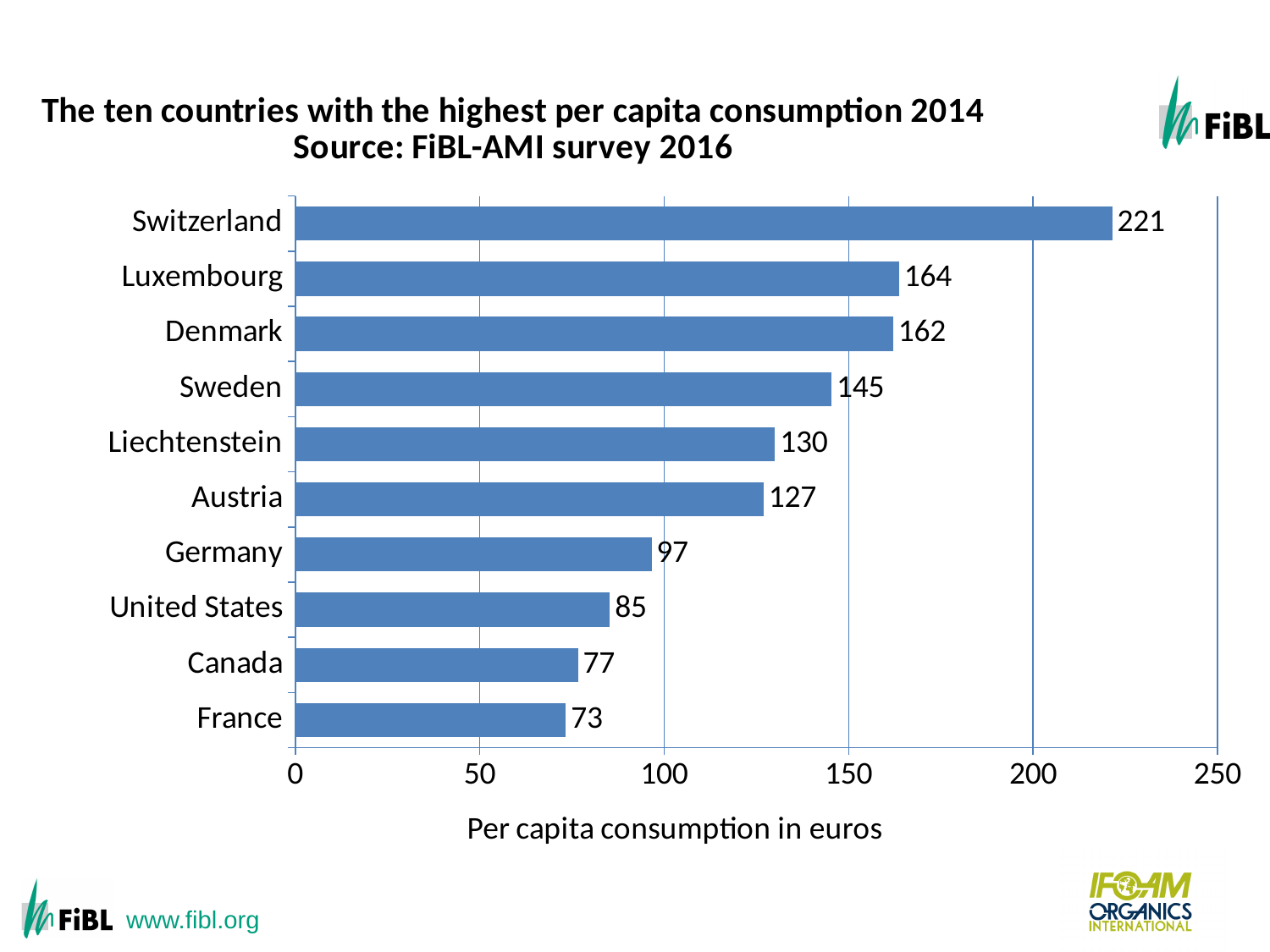
What is the label of the horizontal axis? Per capita consumption in euros How many countries are shown in the chart? 10 Which country has the lowest per capita consumption? France Which has a higher per capita consumption, Sweden or Austria? Sweden Which country has the highest per capita consumption? Switzerland What is the per capita consumption for Liechtenstein? 130 Is the value for Denmark greater or less than 150? greater What kind of chart is shown on the slide? Bar chart What is the difference in per capita consumption between Switzerland and Luxembourg? 57 What is the per capita consumption for Switzerland? 221 What is the difference in per capita consumption between the United States and Canada? 8 What is the per capita consumption for Germany? 97